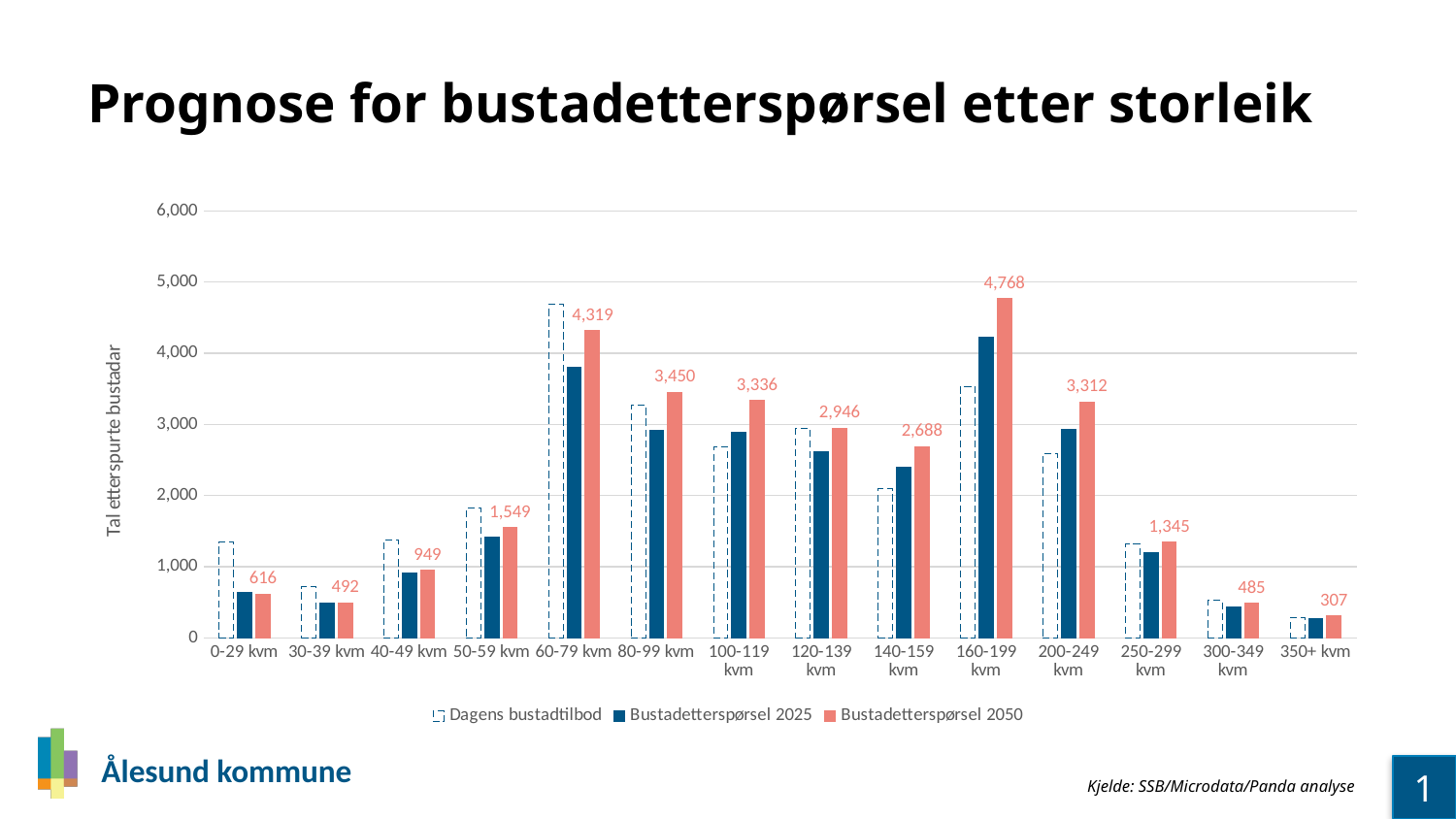
What is the difference between the Bustadetterspørsel 2050 values for 80-99 kvm and 100-119 kvm? 114 Is the Bustadetterspørsel 2025 value for 160-199 kvm greater or less than 4,000? greater Which size category has the lowest Bustadetterspørsel 2050 value? 350+ kvm How many series does the legend list? 3 What is the Bustadetterspørsel 2050 value for 60-79 kvm? 4,319 How many size categories are shown on the x axis? 14 Which has the larger Bustadetterspørsel 2050 value, 100-119 kvm or 120-139 kvm? 100-119 kvm Is the Dagens bustadtilbod value for 60-79 kvm greater or less than 4,000? greater What is the Bustadetterspørsel 2050 value for 160-199 kvm? 4,768 What kind of chart is shown on the slide? bar chart What is the difference between the Bustadetterspørsel 2050 values for 160-199 kvm and 60-79 kvm? 449 Which size category has the highest Bustadetterspørsel 2050 value? 160-199 kvm